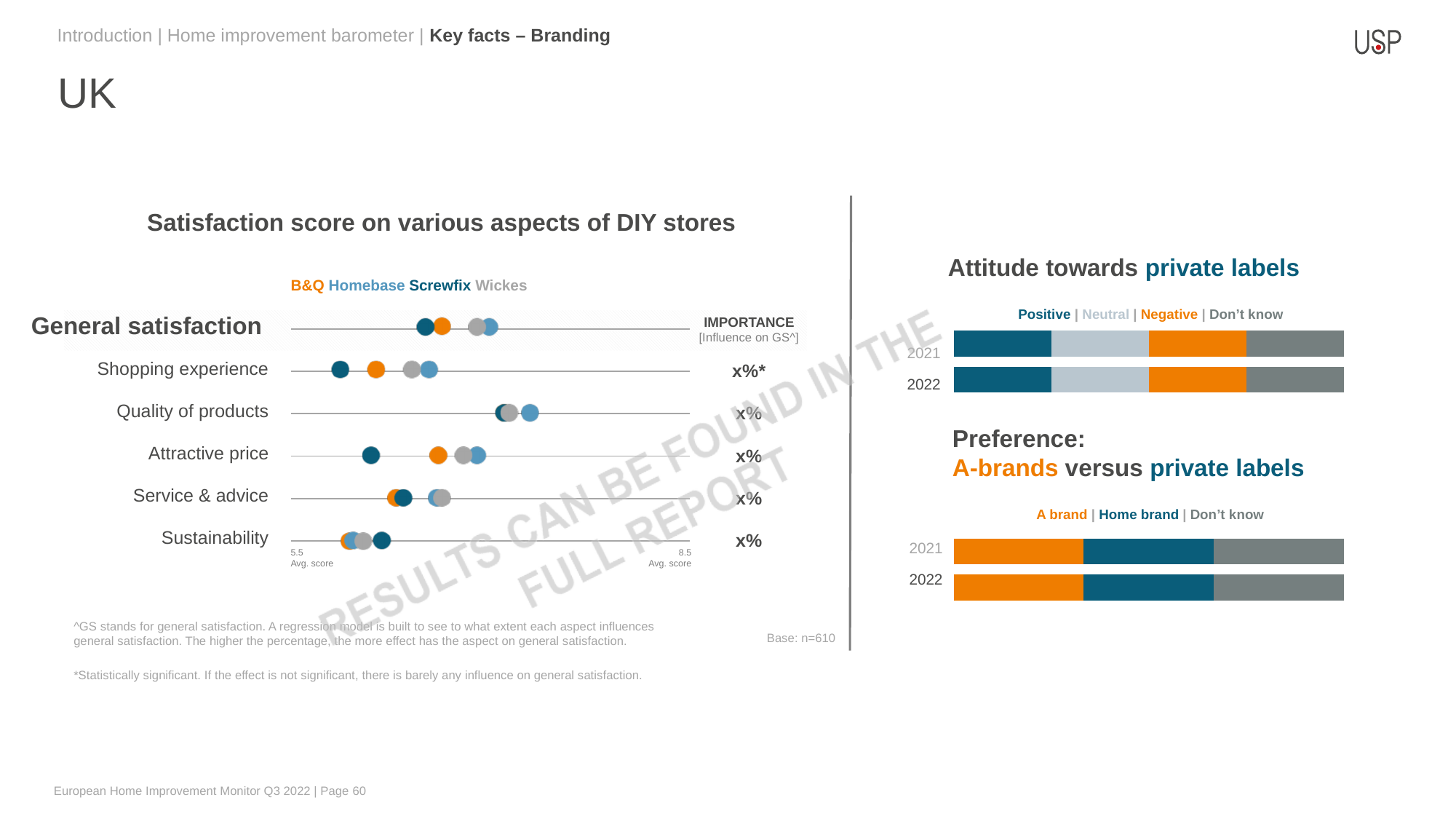
How many categories does the legend of the 'Attitude towards private labels' chart list? 4 In the 'Satisfaction score on various aspects of DIY stores' chart, which brand has the lowest score for Shopping experience? Screwfix How many DIY store brands does the legend of the 'Satisfaction score on various aspects of DIY stores' chart list? 4 Which years are compared in the 'Preference: A-brands versus private labels' chart? 2021 and 2022 In the 'Satisfaction score on various aspects of DIY stores' chart, which brand has the lowest score for Attractive price? Screwfix How many aspects (rows) are plotted in the 'Satisfaction score on various aspects of DIY stores' chart? 6 What are the minimum and maximum values shown on the average score axis of the 'Satisfaction score on various aspects of DIY stores' chart? 5.5 and 8.5 What kind of chart is 'Satisfaction score on various aspects of DIY stores'? Dot plot What kind of chart is 'Attitude towards private labels'? Stacked bar chart In the 'Satisfaction score on various aspects of DIY stores' chart, which brand has the lowest score for Sustainability? B&Q In the 'Satisfaction score on various aspects of DIY stores' chart, which scores higher on Quality of products: Homebase or Screwfix? Homebase In the 'Satisfaction score on various aspects of DIY stores' chart, which brand has the highest score for Shopping experience? Homebase